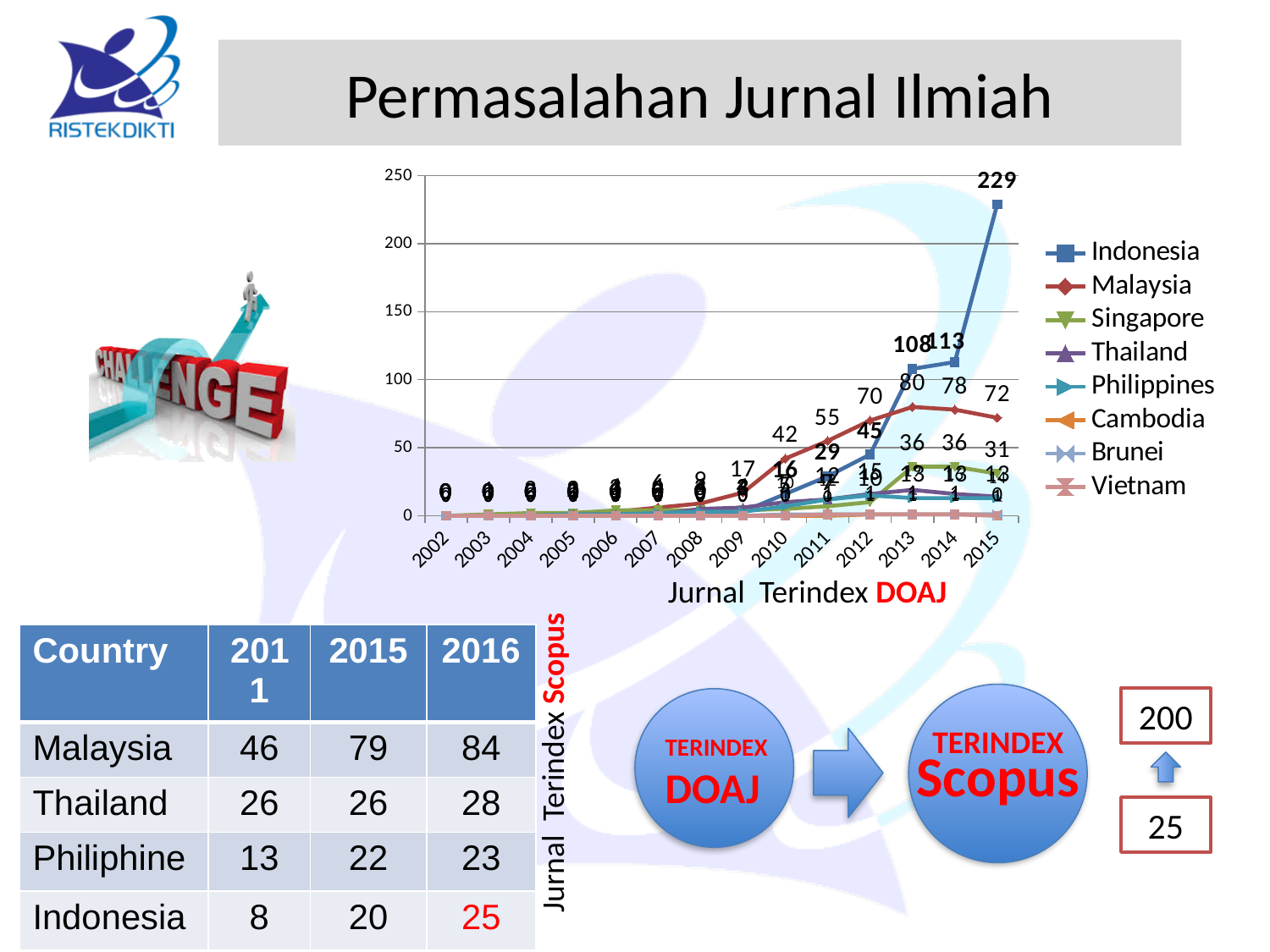
What kind of chart is shown on the slide? line chart How many series does the legend of the chart list? 8 Is the value for Indonesia in 2015 greater or less than 200? greater Which country has the highest value in 2015? Indonesia What is the value for Malaysia in 2015? 72 What is the difference between the values for Indonesia and Malaysia in 2015? 157 In 2013, which is larger: the value for Indonesia or the value for Malaysia? Indonesia What is the value for Singapore in 2015? 31 Does the Indonesia line rise or fall from 2010 to 2015? rise What is the value for Indonesia in 2015? 229 How many years are shown along the x axis of the chart? 14 What is the value for Malaysia in 2012? 70